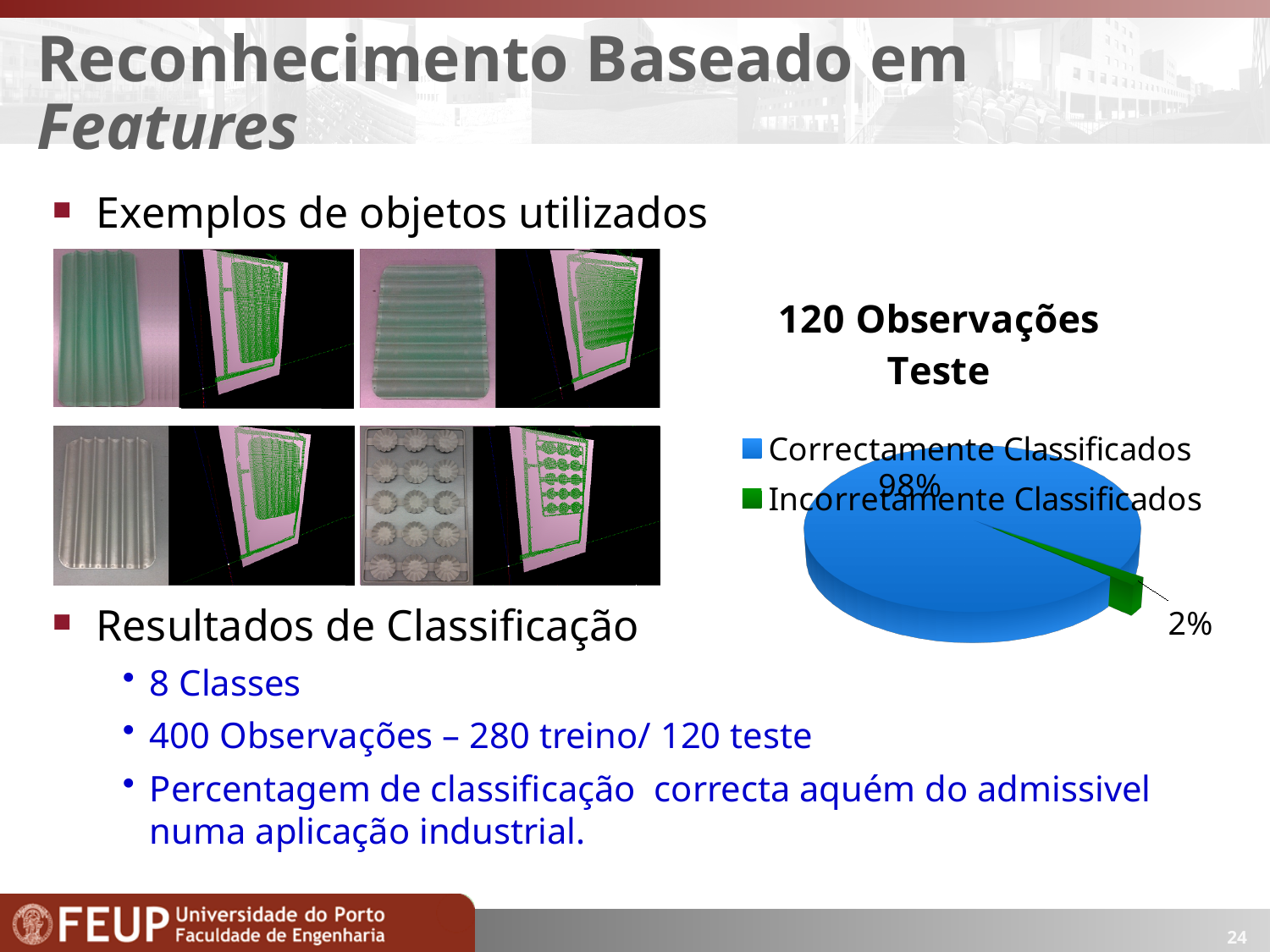
What is the difference in percentage points between the Correctamente Classificados and Incorretamente Classificados slices? 96 What kind of chart is shown on the slide? pie chart Which slice of the pie chart is the largest? Correctamente Classificados How many slices does the pie chart have? 2 What share of the pie is labelled for Incorretamente Classificados? 2% Which slice of the pie chart is the smallest? Incorretamente Classificados What colour is the Incorretamente Classificados slice in the pie chart? green How many series does the legend of the pie chart list? 2 What is the title of the pie chart? 120 Observações Teste Which is larger in the pie chart: Correctamente Classificados or Incorretamente Classificados? Correctamente Classificados What share of the pie is labelled for Correctamente Classificados? 98%